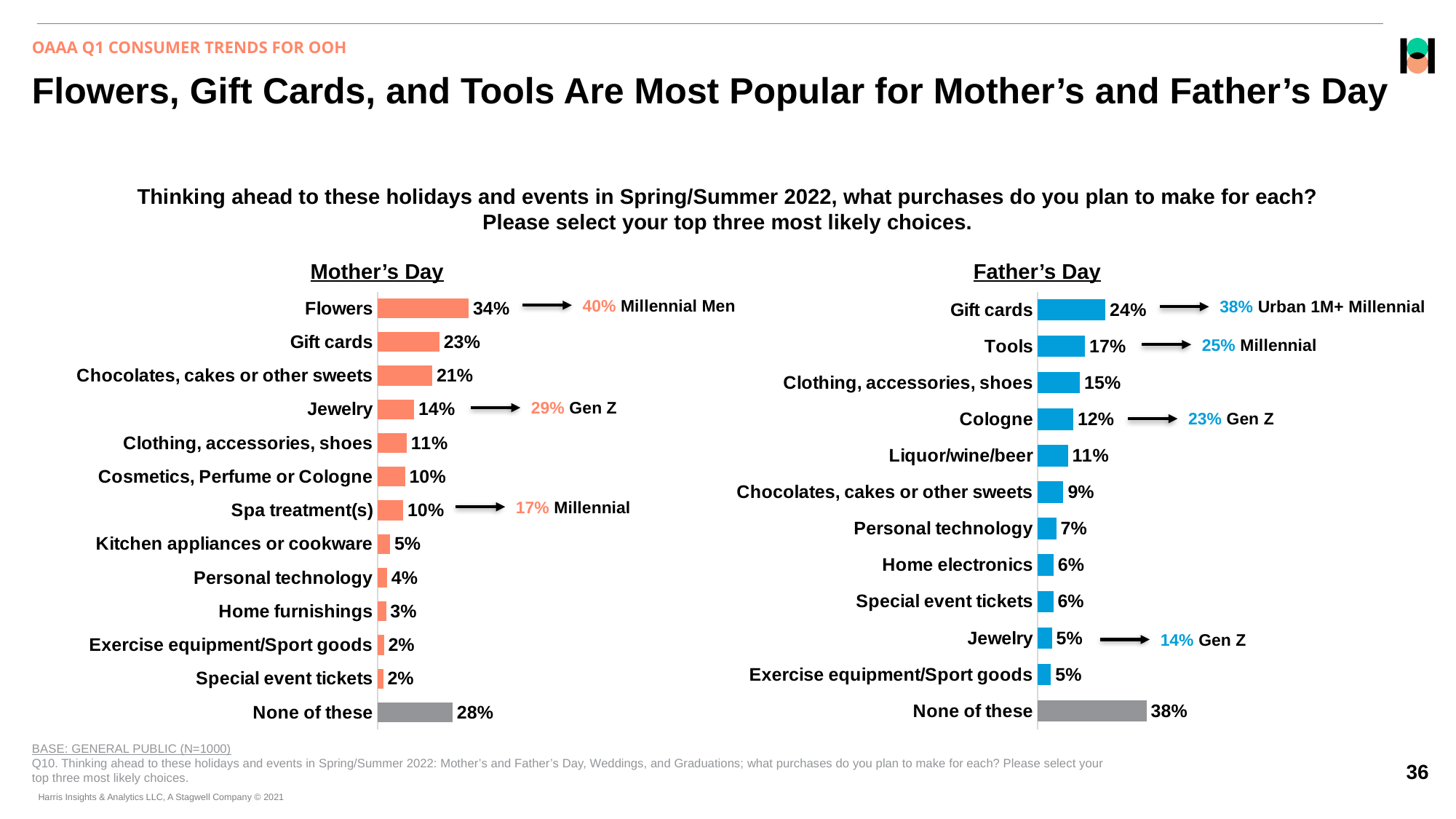
Which is larger: Gift cards in the Mother's Day chart or Gift cards in the Father's Day chart? Father's Day In the Mother's Day chart, what is the difference between Flowers and Gift cards? 11% In the Father's Day chart, which purchase category (excluding None of these) has the highest value? Gift cards How many purchase categories, including None of these, are shown in the Father's Day chart? 12 In the Mother's Day chart, which category has the lowest value, Home furnishings or Kitchen appliances or cookware? Home furnishings How many purchase categories, including None of these, are shown in the Mother's Day chart? 13 In the Father's Day chart, what percentage plan to purchase Tools? 17% What type of chart is used for the Mother's Day data? Bar chart In the Mother's Day chart, what percentage plan to purchase Flowers? 34% In the Father's Day chart, what is the difference between Gift cards and Cologne? 12% In the Father's Day chart, what percentage of Gen Z is called out for Cologne? 23% In the Mother's Day chart, what is the value for None of these? 28%